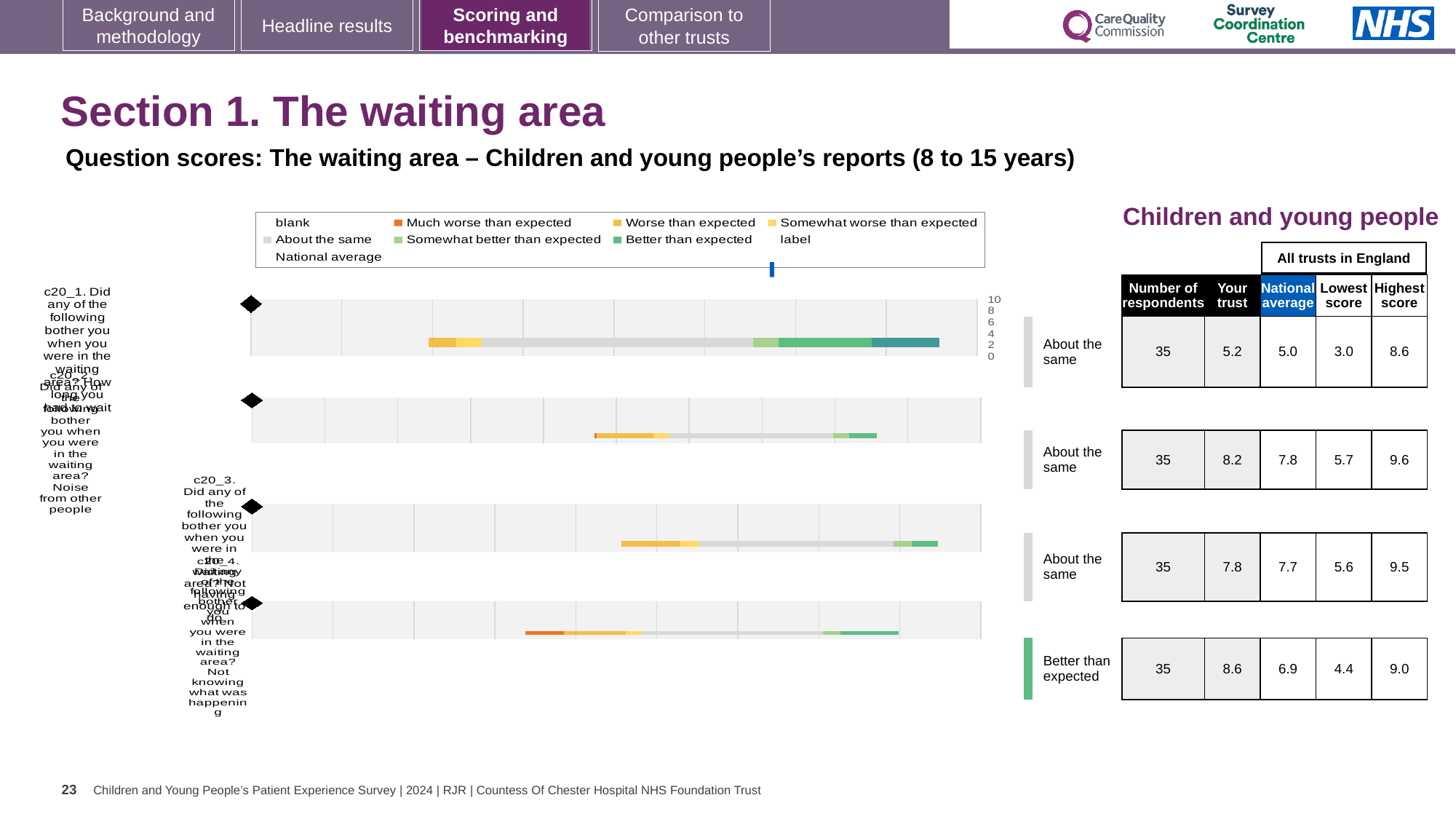
What kind of chart is shown on the slide? bar chart Which question is rated 'Better than expected' on the slide? c20_4 In the table beside the chart, which question has the lowest 'Your trust' score? c20_1 In the table beside the chart, what is the 'Your trust' score for the first question (c20_1)? 5.2 For the second question (c20_2), which is larger: the 'Your trust' score or the national average? Your trust In the table beside the chart, what is the difference between the 'Your trust' score and the national average for the fourth question (c20_4)? 1.7 How many respondents are listed for each question in the table? 35 What is the maximum value shown on the chart's score axis? 10 How many question bars are plotted in the chart? 4 In the table beside the chart, what is the national average for the second question (c20_2)? 7.8 How many entries does the chart legend list? 9 In the table beside the chart, which question has the highest 'Your trust' score? c20_4